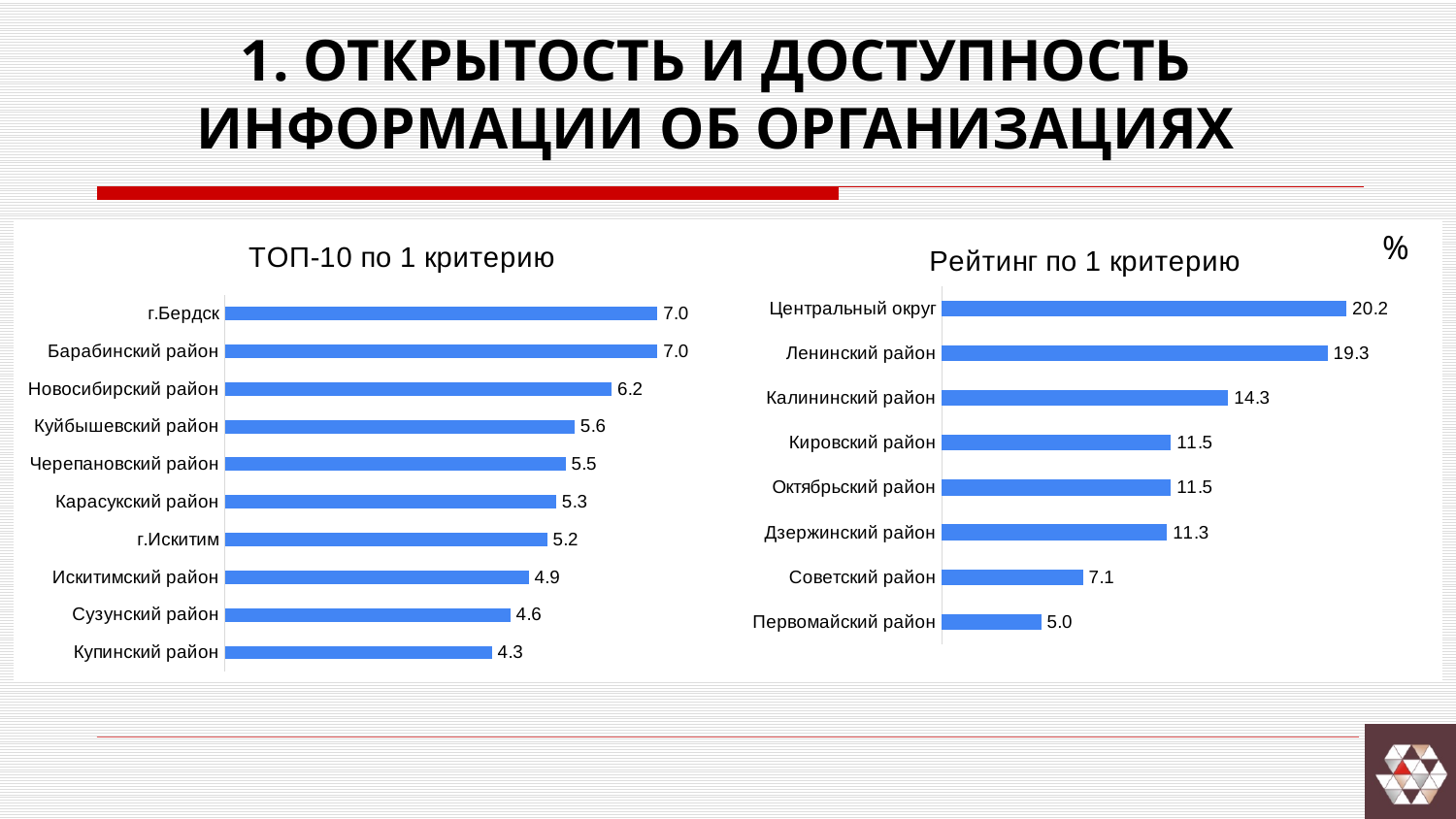
In the chart titled 'ТОП-10 по 1 критерию', which category has the lowest value? Купинский район In the chart titled 'Рейтинг по 1 критерию', what is the difference between the values for Центральный округ and Ленинский район? 0.9 What type of chart is the chart titled 'Рейтинг по 1 критерию'? Bar chart In the chart titled 'Рейтинг по 1 критерию', which category has the highest value? Центральный округ In the chart titled 'Рейтинг по 1 критерию', which category has the lowest value? Первомайский район In the chart titled 'ТОП-10 по 1 критерию', what is the value for Купинский район? 4.3 In the chart titled 'Рейтинг по 1 критерию', how many categories are shown? 8 In the chart titled 'ТОП-10 по 1 критерию', which is larger: the value for Карасукский район or the value for Искитимский район? Карасукский район In the chart titled 'ТОП-10 по 1 критерию', what is the difference between the values for Куйбышевский район and Сузунский район? 1.0 In the chart titled 'ТОП-10 по 1 критерию', how many categories are shown? 10 In the chart titled 'ТОП-10 по 1 критерию', what is the value for Новосибирский район? 6.2 In the chart titled 'Рейтинг по 1 критерию', what is the value for Калининский район? 14.3